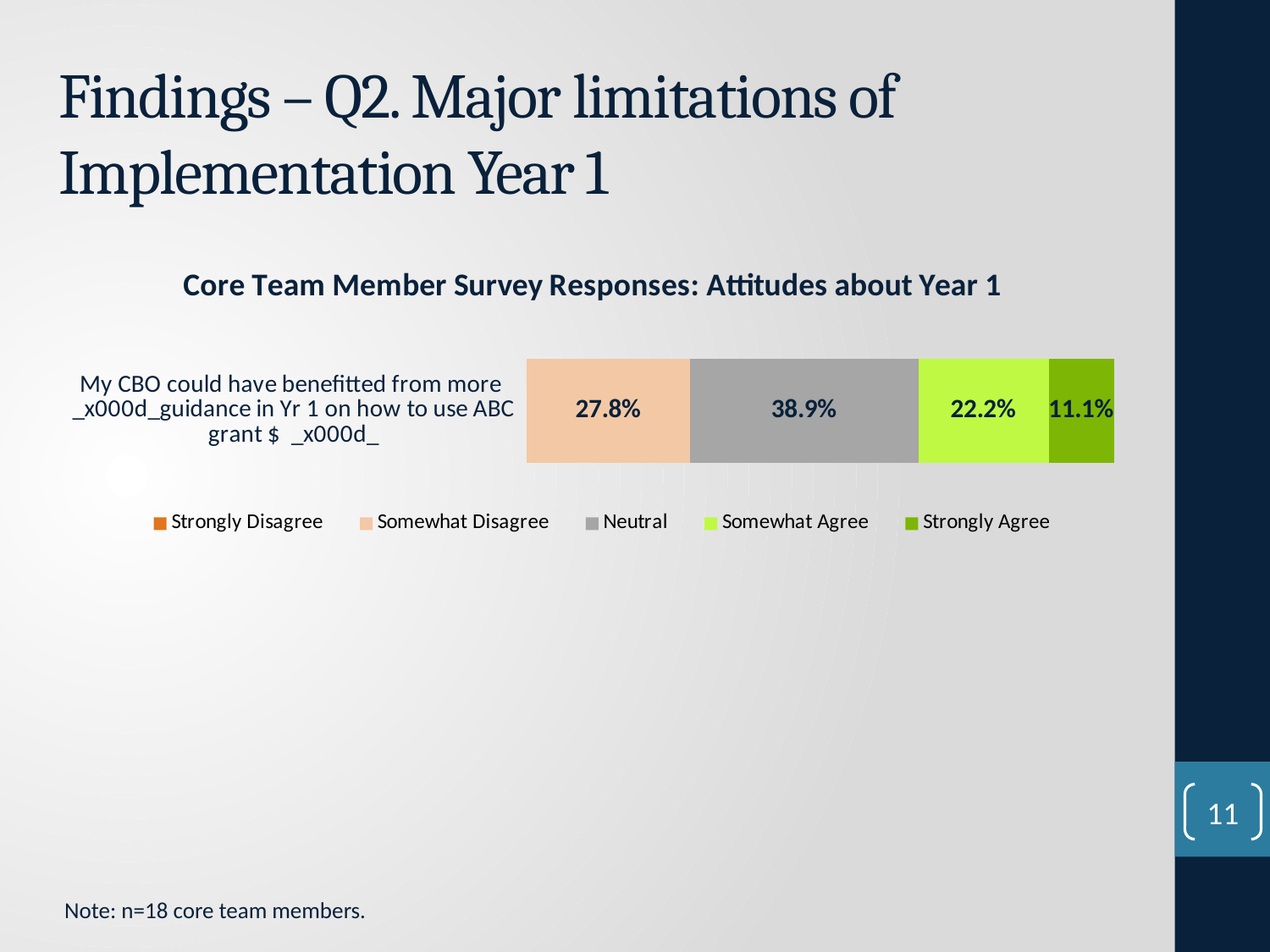
What kind of chart is shown on the slide? Stacked bar chart Which response option has the largest share of the bar? Neutral Which is larger, the Somewhat Disagree share or the Somewhat Agree share? Somewhat Disagree How many response options does the legend list? 5 What is the difference between the Somewhat Agree share and the Strongly Agree share? 11.1% What percentage of respondents chose Somewhat Disagree? 27.8% What percentage of core team members responded Neutral to the statement about needing more guidance in Yr 1? 38.9% What percentage of respondents chose Somewhat Agree? 22.2% What is the title of the chart? Core Team Member Survey Responses: Attitudes about Year 1 Of the labelled segments in the bar, which response option has the smallest share? Strongly Agree What percentage of respondents chose Strongly Agree? 11.1% How many percentage points larger is the Neutral share than the Somewhat Disagree share? 11.1%